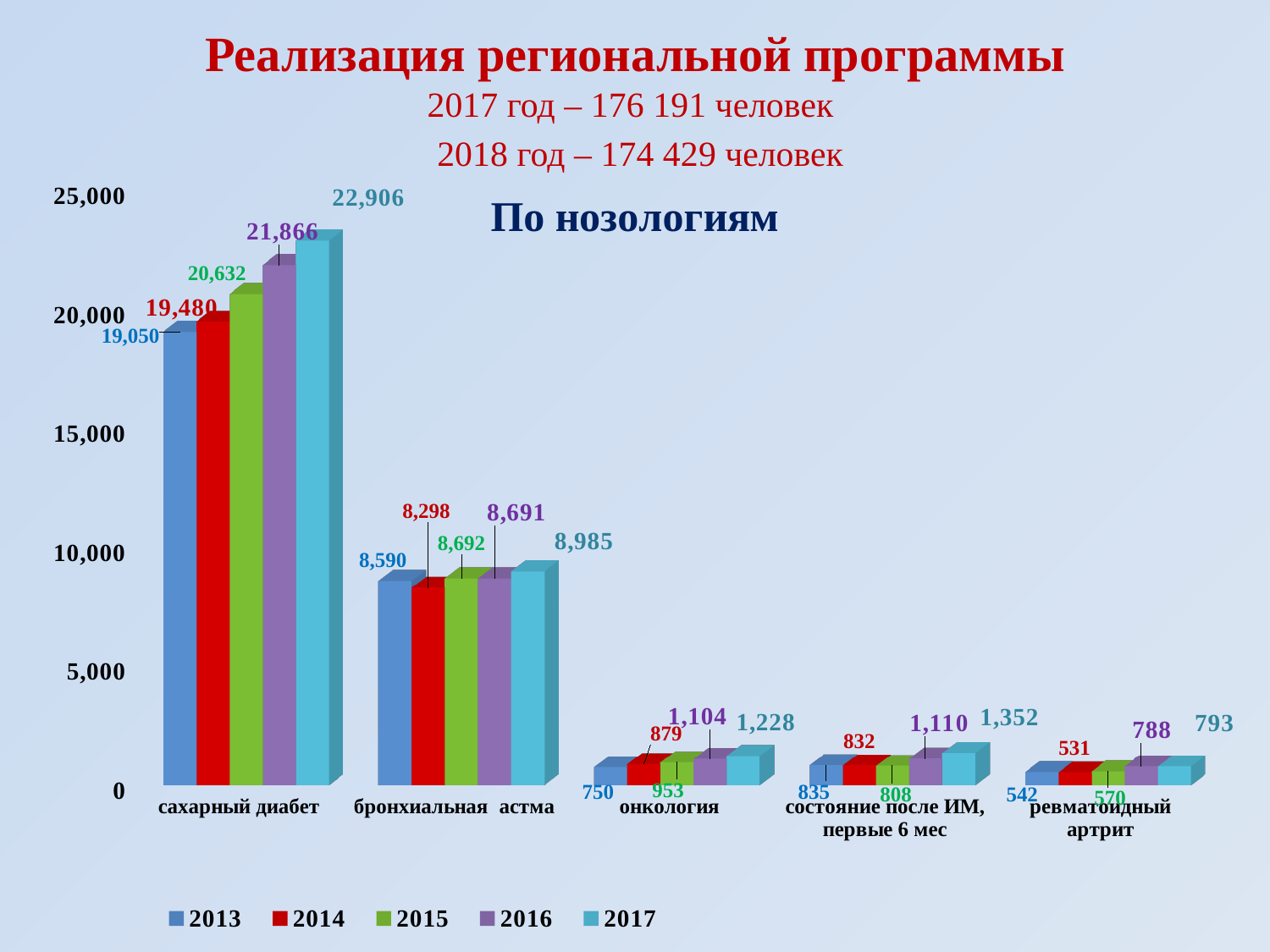
What is the value for 2015 in the состояние после ИМ, первые 6 мес category? 808 Which category has the highest value for 2017? сахарный диабет Do the values for ревматоидный артрит rise or fall from 2015 to 2017? rise What is the value for 2017 in the сахарный диабет category? 22,906 Which is larger for онкология: the 2014 value or the 2015 value? 2015 How many categories are shown on the x axis? 5 Which category has the lowest value for 2013? ревматоидный артрит What kind of chart is shown on the slide? bar chart What is the difference between the 2017 and 2013 values for сахарный диабет? 3,856 How many series does the legend list? 5 What is the value for 2013 in the бронхиальная астма category? 8,590 What is the value for 2016 in the онкология category? 1,104